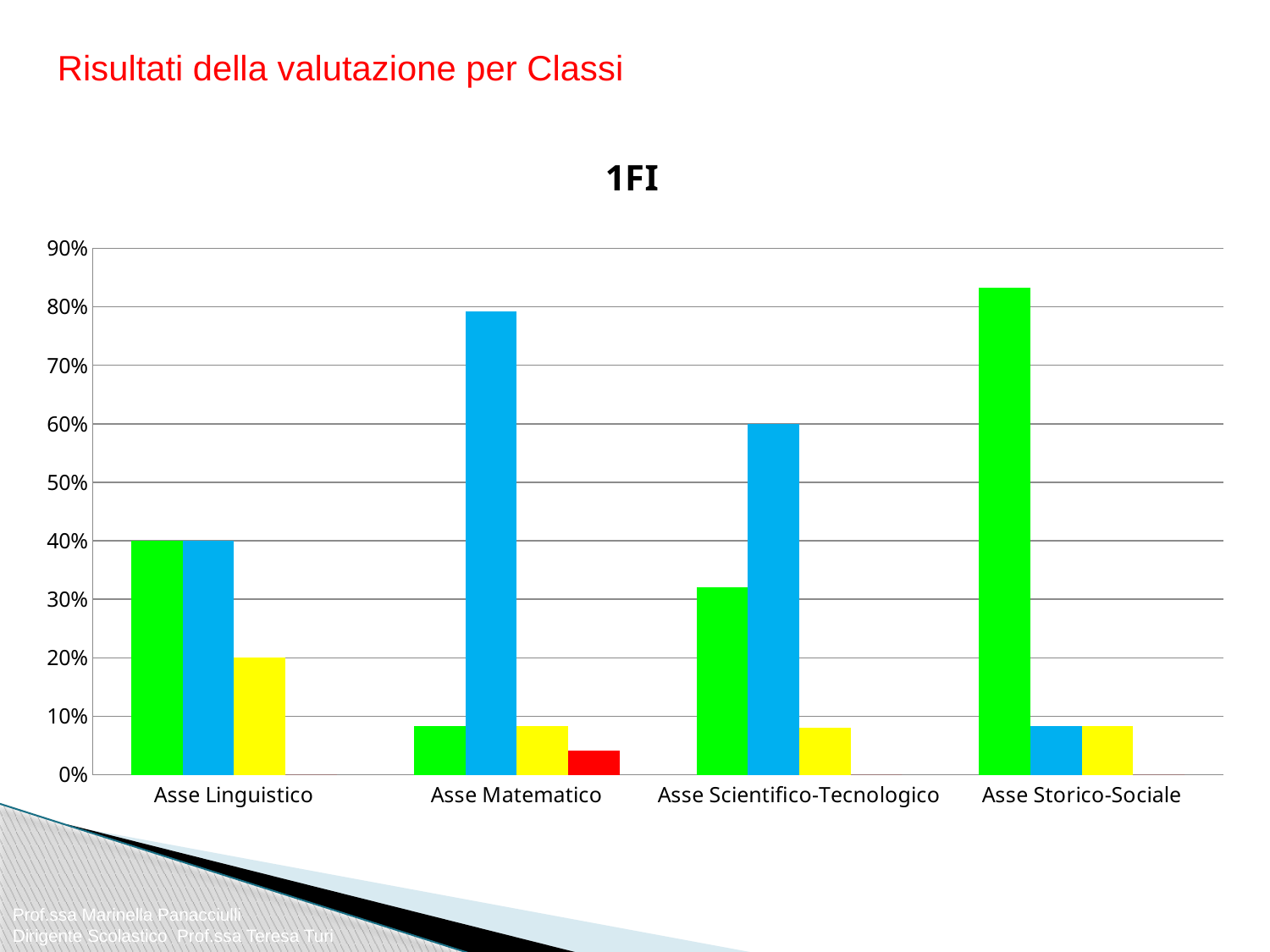
What is the value of the green bar for Asse Linguistico? 40% Is the value of the green bar for Asse Matematico greater or less than 10%? less In which category is the green bar the highest? Asse Storico-Sociale What is the value of the blue bar for Asse Scientifico-Tecnologico? 60% How many categories are shown on the x axis of the chart? 4 Is the value of the green bar for Asse Storico-Sociale greater or less than 80%? greater In which category is the blue bar the highest? Asse Matematico For Asse Scientifico-Tecnologico, which is larger, the green bar or the blue bar? the blue bar What is the title of the chart? 1FI Is the value of the blue bar for Asse Matematico greater or less than 70%? greater What kind of chart is shown on the slide? bar chart What is the value of the yellow bar for Asse Linguistico? 20%